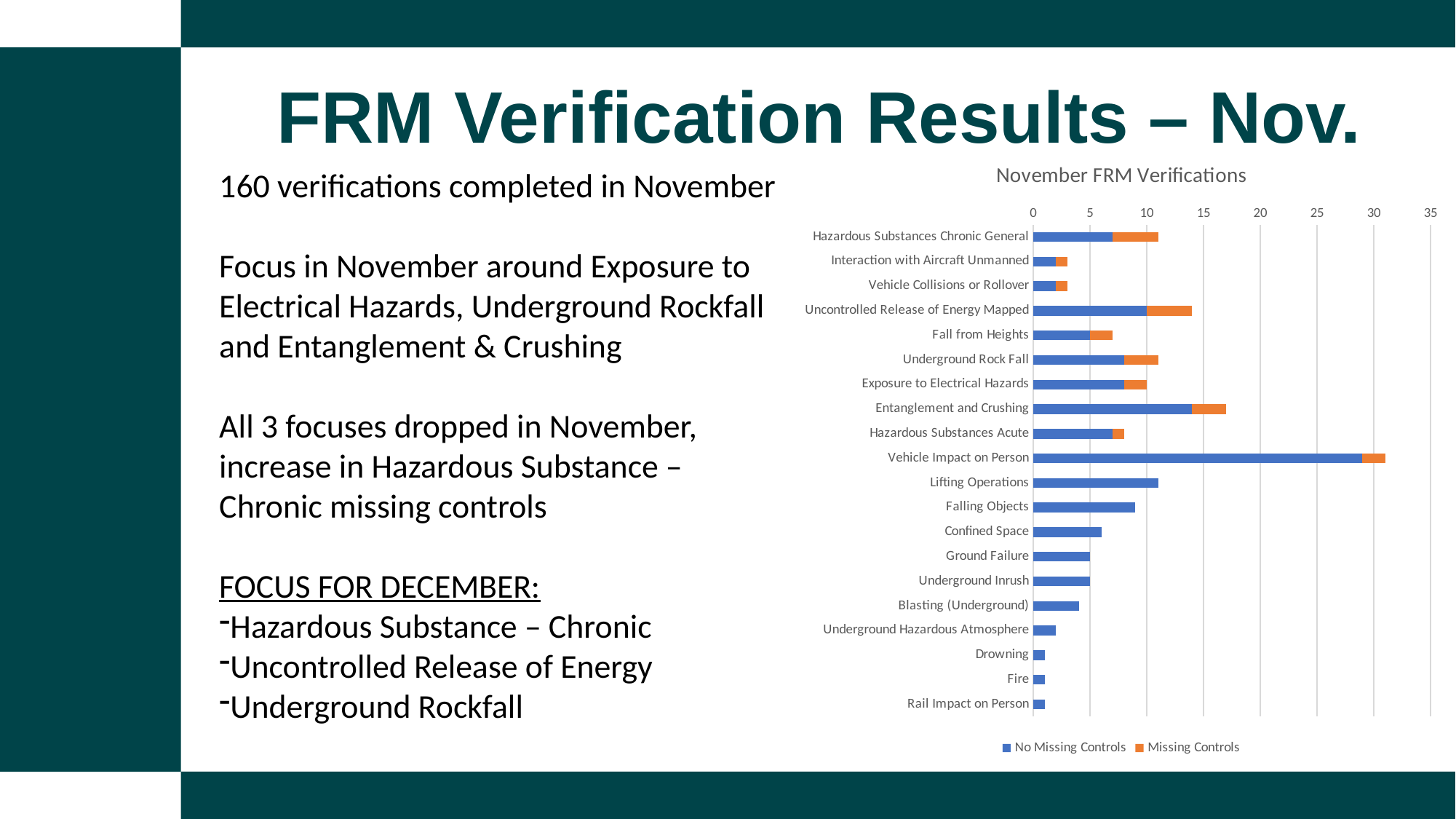
What are the two series named in the legend? No Missing Controls and Missing Controls How many series does the chart legend list? 2 What kind of chart is shown on the slide? Bar chart What is the title of the chart? November FRM Verifications Is the total bar length for Vehicle Impact on Person greater or less than 25? greater Is the total bar length for Confined Space greater or less than 10? less Is the total bar length for Entanglement and Crushing greater or less than 15? greater Which has the longer bar, Entanglement and Crushing or Underground Rock Fall? Entanglement and Crushing How many categories are plotted in the chart? 20 Which category has the longest bar in the chart? Vehicle Impact on Person Which has the longer bar, Falling Objects or Confined Space? Falling Objects